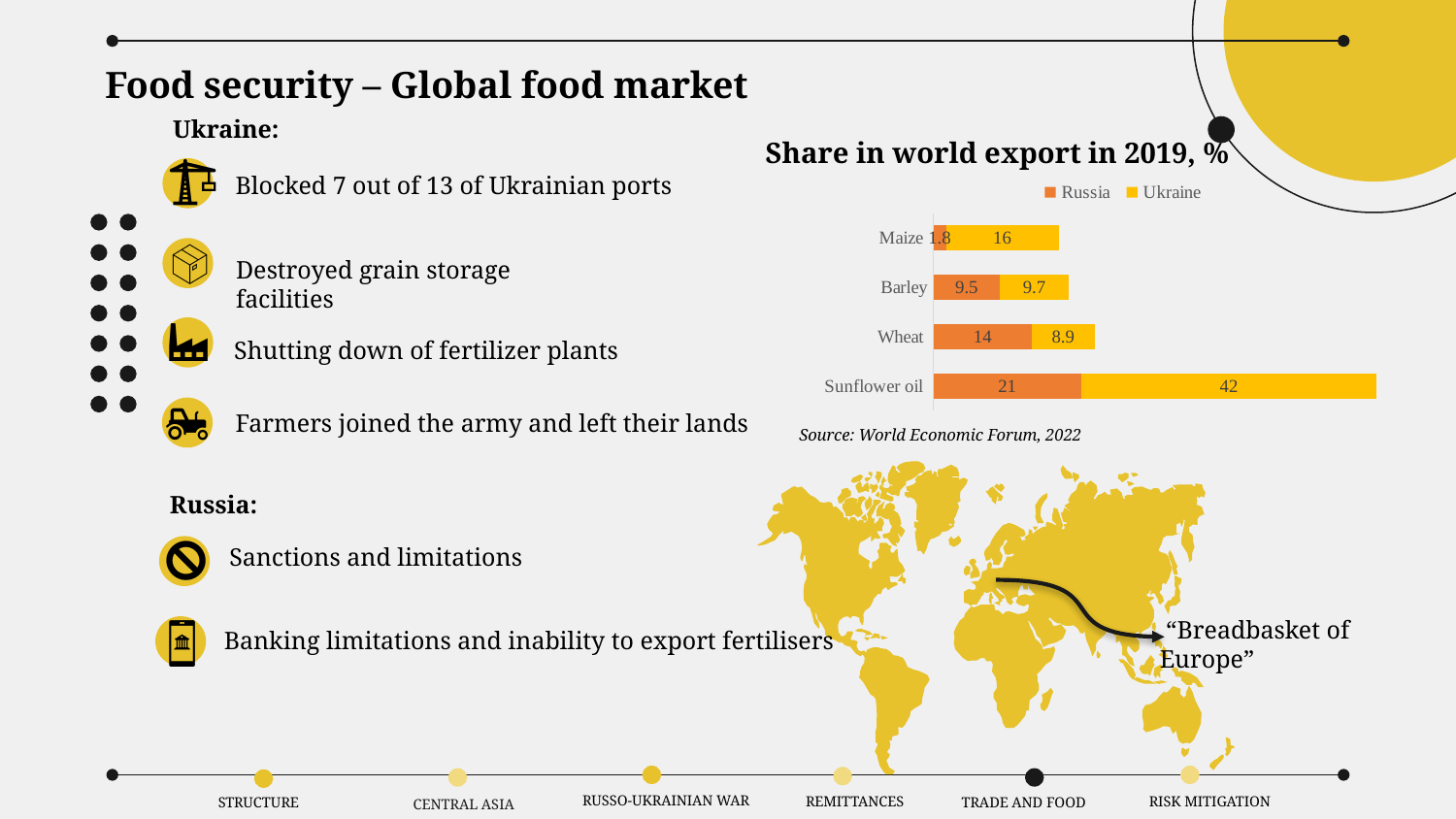
How many products are shown in the 'Share in world export in 2019, %' chart? 4 What is Russia's share in world export of wheat in 2019? 14 What is the combined share of Russia and Ukraine in world export of wheat in 2019? 22.9 What is Russia's share in world export of maize in 2019? 1.8 How many series does the legend of the 'Share in world export in 2019, %' chart list? 2 For wheat, which country has the larger share in world export in 2019, Russia or Ukraine? Russia What is Ukraine's share in world export of barley in 2019? 9.7 What is the combined share of Russia and Ukraine in world export of sunflower oil in 2019? 63 Which product has the lowest Russia share in world export in 2019? Maize What is the difference between Ukraine's and Russia's share in world export of sunflower oil in 2019? 21 Which product has the highest Ukraine share in world export in 2019? Sunflower oil What is Ukraine's share in world export of sunflower oil in 2019? 42